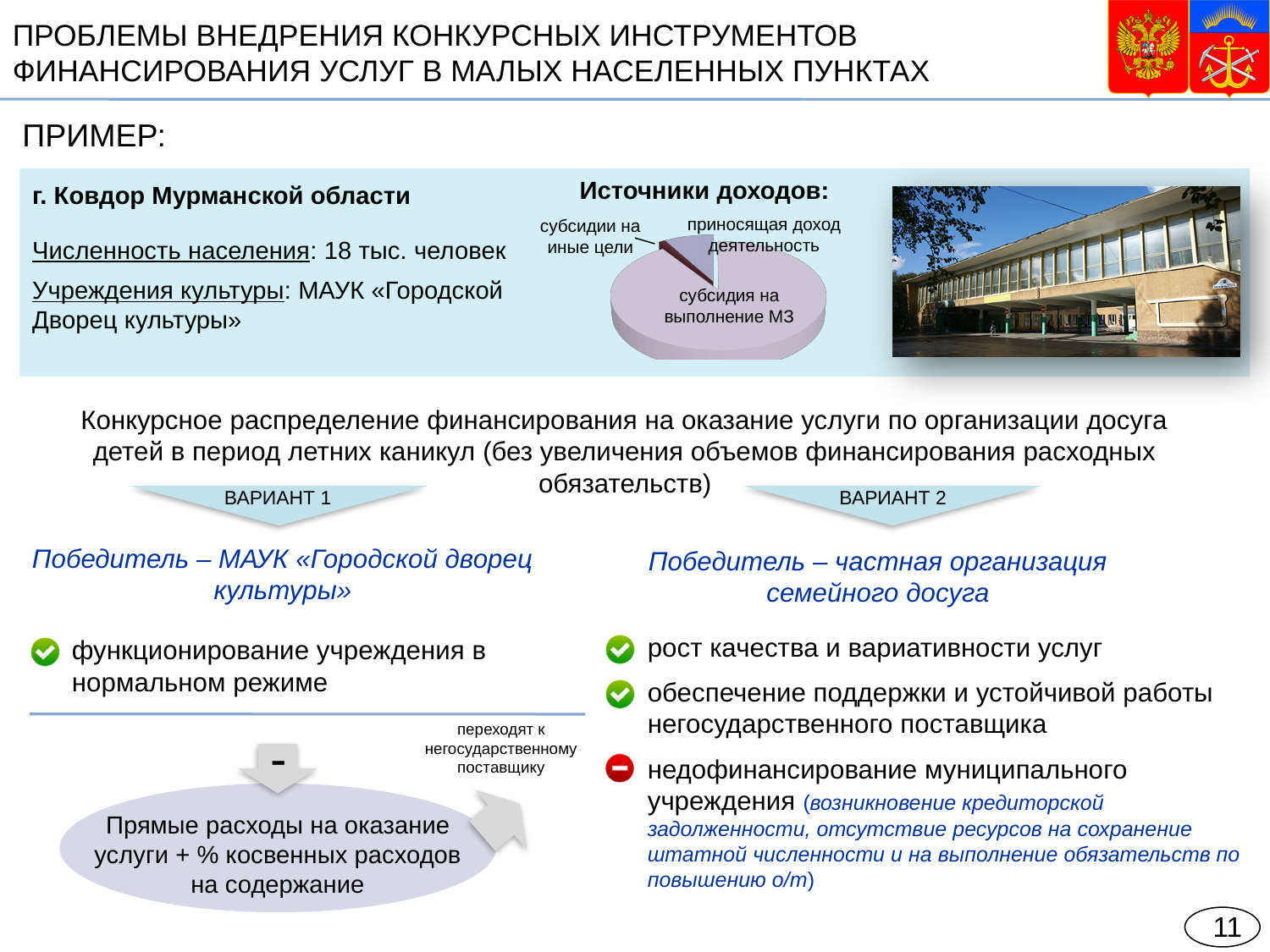
What kind of chart is shown under the heading "Источники доходов:"? pie chart What is the title of the pie chart on the slide? Источники доходов: In the "Источники доходов:" pie chart, which is larger: the slice for "субсидия на выполнение МЗ" or the slice for "приносящая доход деятельность"? субсидия на выполнение МЗ Which three income sources are labelled on the "Источники доходов:" pie chart? субсидии на иные цели, приносящая доход деятельность, субсидия на выполнение МЗ Which slice of the "Источники доходов:" pie chart is the largest? субсидия на выполнение МЗ In the "Источники доходов:" pie chart, which is larger: the slice for "субсидия на выполнение МЗ" or the slice for "субсидии на иные цели"? субсидия на выполнение МЗ How many slices does the "Источники доходов:" pie chart have? 3